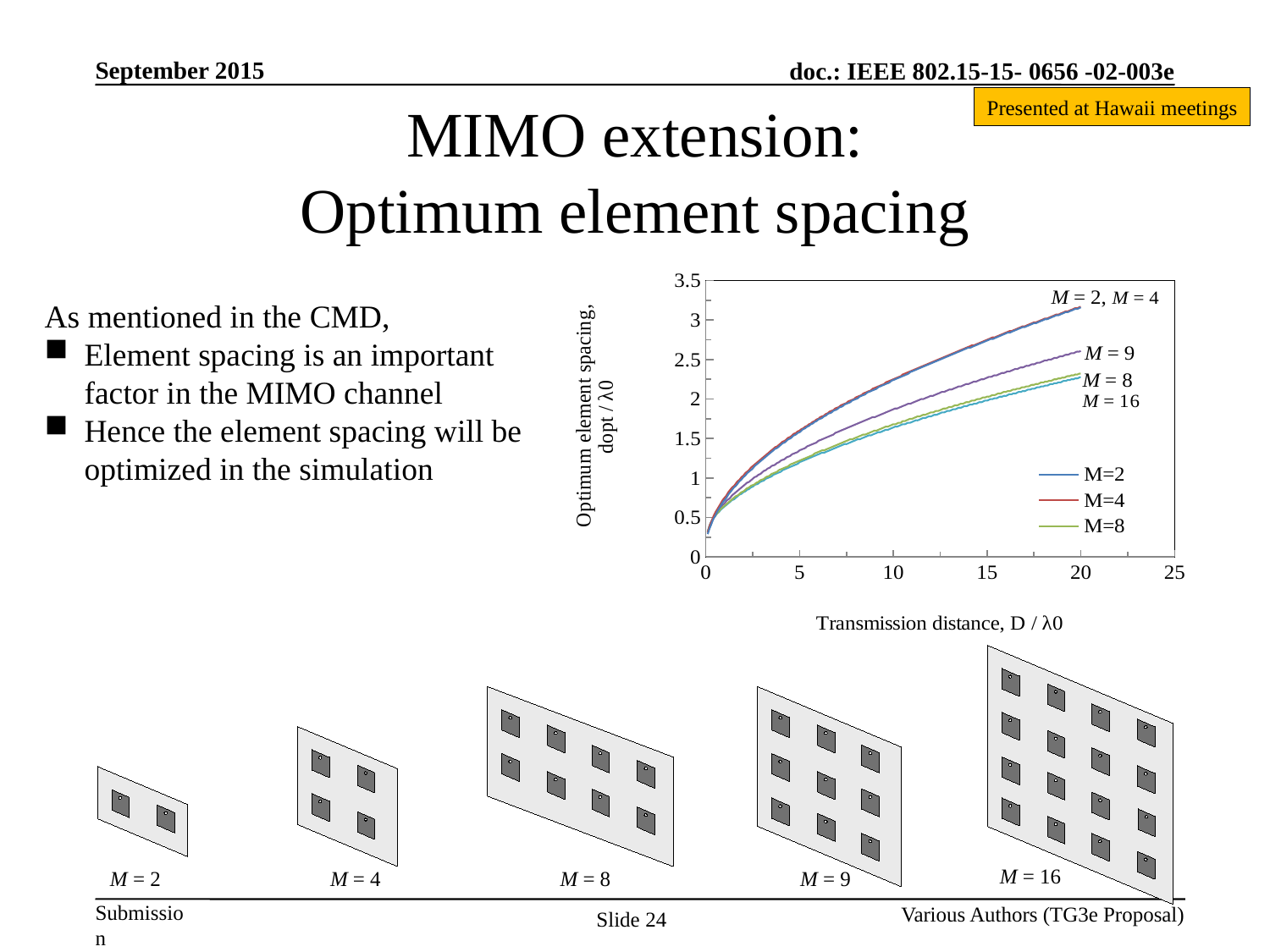
What is the highest tick value shown on the chart's y axis? 3.5 Do the curves rise or fall as the transmission distance increases along the x axis? rise At a transmission distance of 20, which curve has the larger value, M=2 or M=8? M=2 At a transmission distance of 20, which curve has the larger value, M=9 or M=16? M=9 At a transmission distance of 20, is the value of the M=2 curve greater or less than 3? greater At a transmission distance of 20, is the value of the M=8 curve greater or less than 2.5? less What is the label of the chart's x axis? Transmission distance, D / λ0 How many series does the chart's legend list? 3 At a transmission distance of 10, is the value of the M=8 curve greater or less than 2? less How many tick values are labelled on the chart's x axis? 6 What kind of chart is shown on the slide? line chart